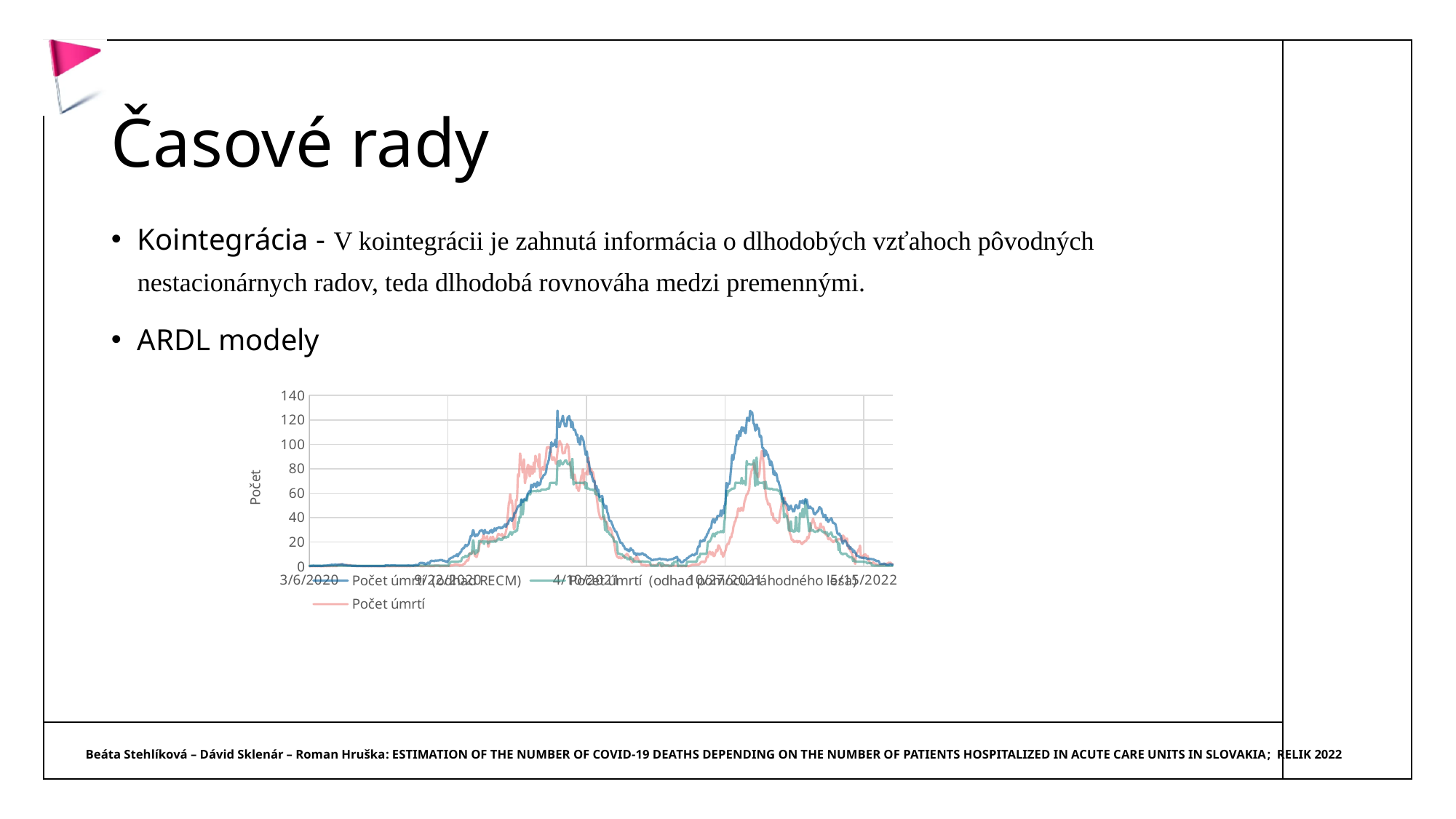
How many date labels are shown along the horizontal axis of the chart? 5 What is the first date label on the horizontal axis of the chart? 3/6/2020 Is the peak value of the 'Počet úmrtí (odhad RECM)' line greater or less than 100? greater What is the highest value shown on the vertical axis of the chart? 140 Is the peak value of the 'Počet úmrtí' line greater or less than 60? greater What is the label of the vertical axis of the chart? Počet What kind of chart is shown on the slide? line chart Is the value of the 'Počet úmrtí' line at 3/6/2020 greater or less than 20? less What is the last date label on the horizontal axis of the chart? 5/15/2022 Do the values in the chart rise steadily, fall steadily, or rise and fall in waves along the horizontal axis? rise and fall in waves Which line reaches the highest value in the chart: 'Počet úmrtí (odhad RECM)' or 'Počet úmrtí (odhad pomocou náhodného lesa)'? Počet úmrtí (odhad RECM) How many series does the chart legend list? 3